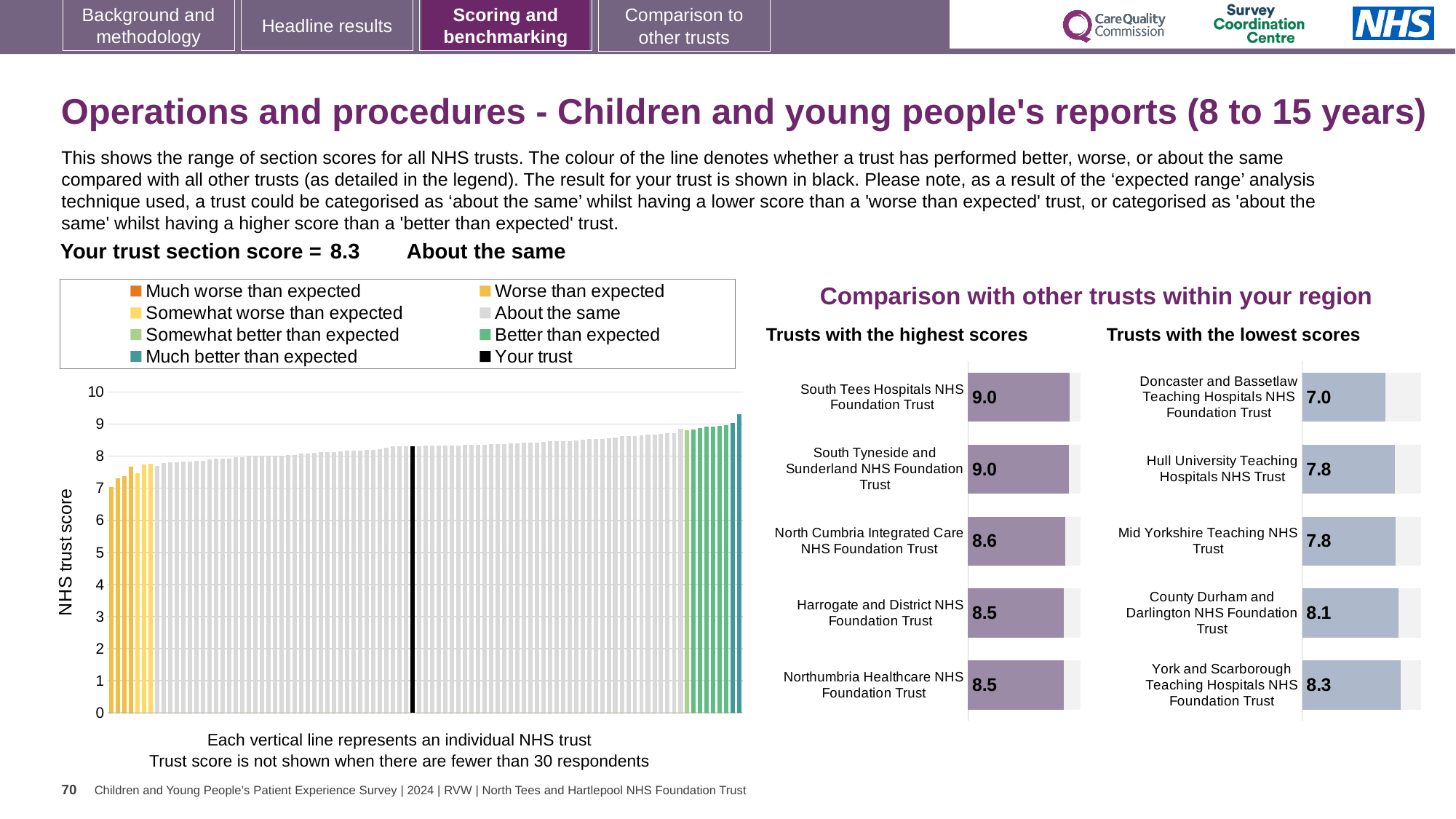
In the 'Trusts with the lowest scores' chart, what is the score for Doncaster and Bassetlaw Teaching Hospitals NHS Foundation Trust? 7.0 What kind of chart is the large 'NHS trust score' chart on the left of the slide? Bar chart In the 'NHS trust score' chart on the left, what is the section score for your trust (the black bar)? 8.3 In the 'Trusts with the highest scores' chart, what is the difference between the scores of South Tees Hospitals NHS Foundation Trust and Northumbria Healthcare NHS Foundation Trust? 0.5 In the 'Trusts with the highest scores' chart, what is the score for North Cumbria Integrated Care NHS Foundation Trust? 8.6 In the 'Trusts with the lowest scores' chart, what is the difference between the scores of County Durham and Darlington NHS Foundation Trust and Doncaster and Bassetlaw Teaching Hospitals NHS Foundation Trust? 1.1 In the 'Trusts with the lowest scores' chart, which trust has the lowest score? Doncaster and Bassetlaw Teaching Hospitals NHS Foundation Trust In the 'NHS trust score' chart on the left, do the values rise or fall from left to right? Rise How many trusts are shown in the 'Trusts with the highest scores' chart? 5 In the 'Trusts with the lowest scores' chart, which trust has the highest score? York and Scarborough Teaching Hospitals NHS Foundation Trust How many entries does the legend above the 'NHS trust score' chart list? 8 In the 'Trusts with the highest scores' chart, which has the larger score: North Cumbria Integrated Care NHS Foundation Trust or Harrogate and District NHS Foundation Trust? North Cumbria Integrated Care NHS Foundation Trust